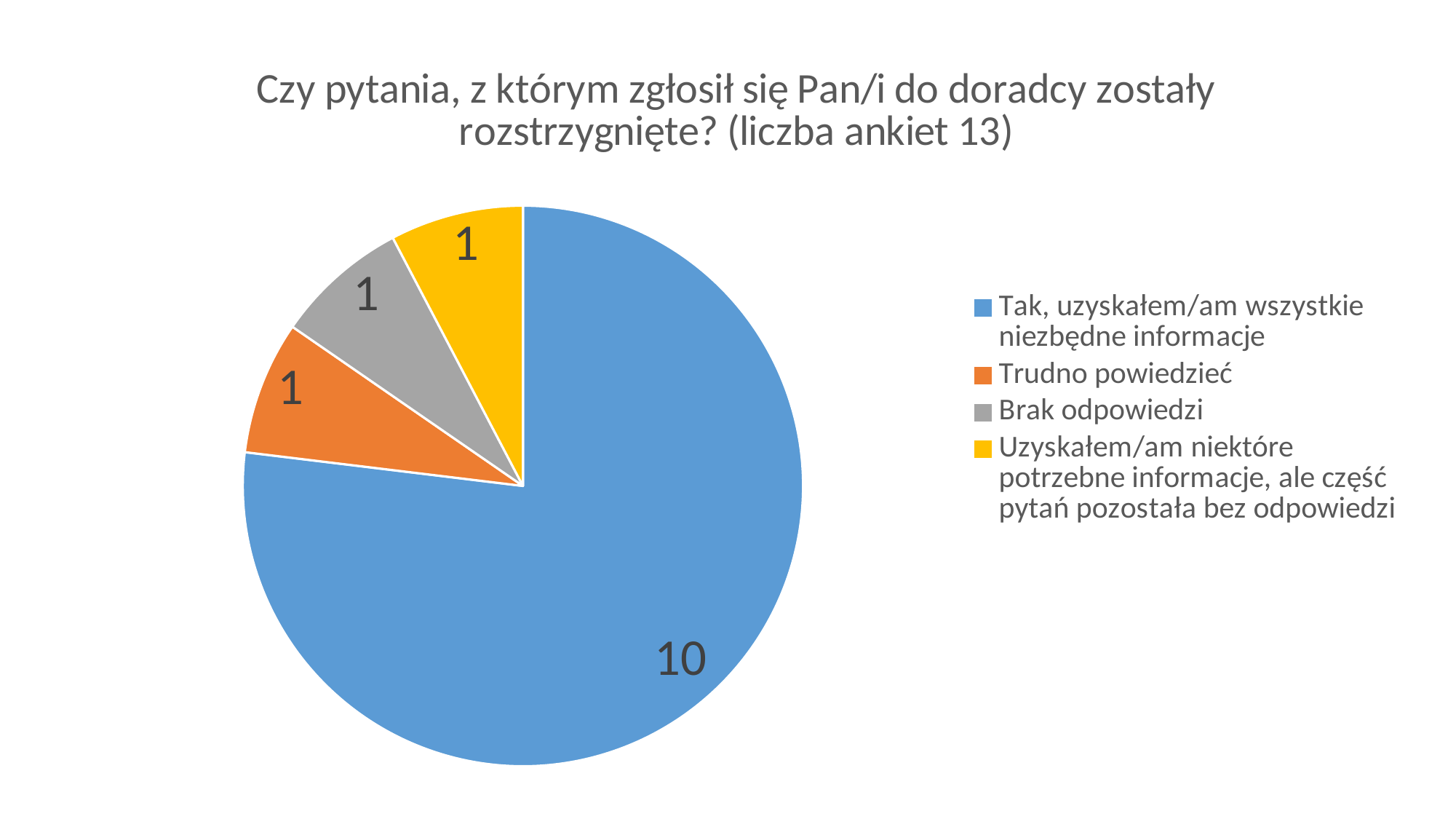
How many slices does the pie chart have? 4 What is the value for "Trudno powiedzieć"? 1 What is the total of all slices in the pie chart? 13 How many entries does the legend list? 4 What is the difference between the value for "Tak, uzyskałem/am wszystkie niezbędne informacje" and the value for "Brak odpowiedzi"? 9 What colour is the slice for "Brak odpowiedzi"? Grey What is the value for "Uzyskałem/am niektóre potrzebne informacje, ale część pytań pozostała bez odpowiedzi"? 1 What type of chart is shown on the slide? Pie chart Which category has the largest slice of the pie? Tak, uzyskałem/am wszystkie niezbędne informacje What is the value for "Brak odpowiedzi"? 1 Which is larger: the value for "Tak, uzyskałem/am wszystkie niezbędne informacje" or the value for "Trudno powiedzieć"? Tak, uzyskałem/am wszystkie niezbędne informacje What is the value for "Tak, uzyskałem/am wszystkie niezbędne informacje"? 10